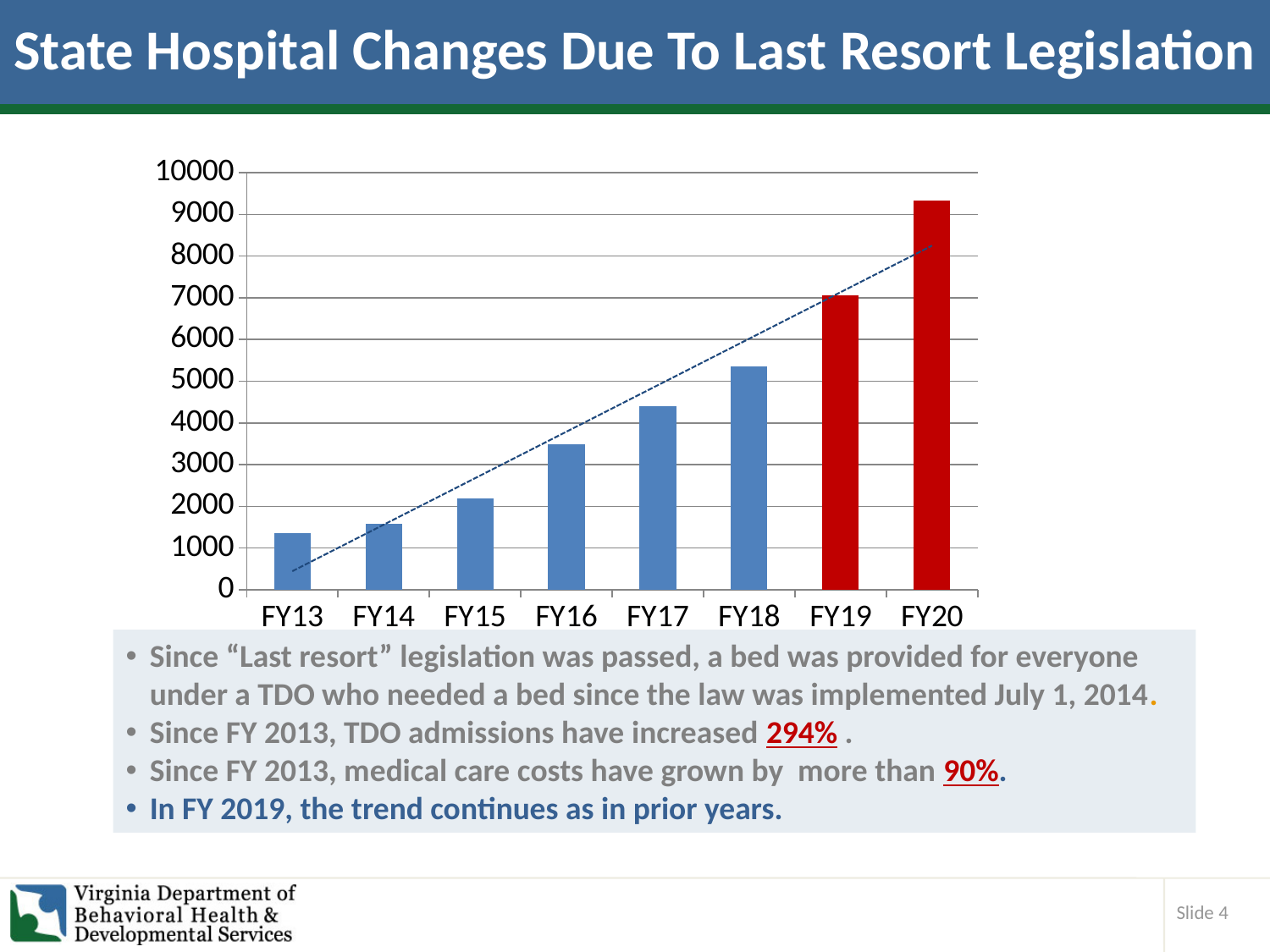
What kind of chart is shown on the slide? bar chart How many fiscal years are plotted on the x axis of the chart? 8 Do the bar values rise or fall from FY13 to FY20? rise Which fiscal years are shown with red bars instead of blue bars? FY19 and FY20 Is the value for FY19 greater or less than 8000? less Which is larger, the value for FY17 or the value for FY15? FY17 Is the value for FY16 greater or less than 3000? greater Is the value for FY13 greater or less than 2000? less Which fiscal year has the highest bar in the chart? FY20 Which fiscal year has the lowest bar in the chart? FY13